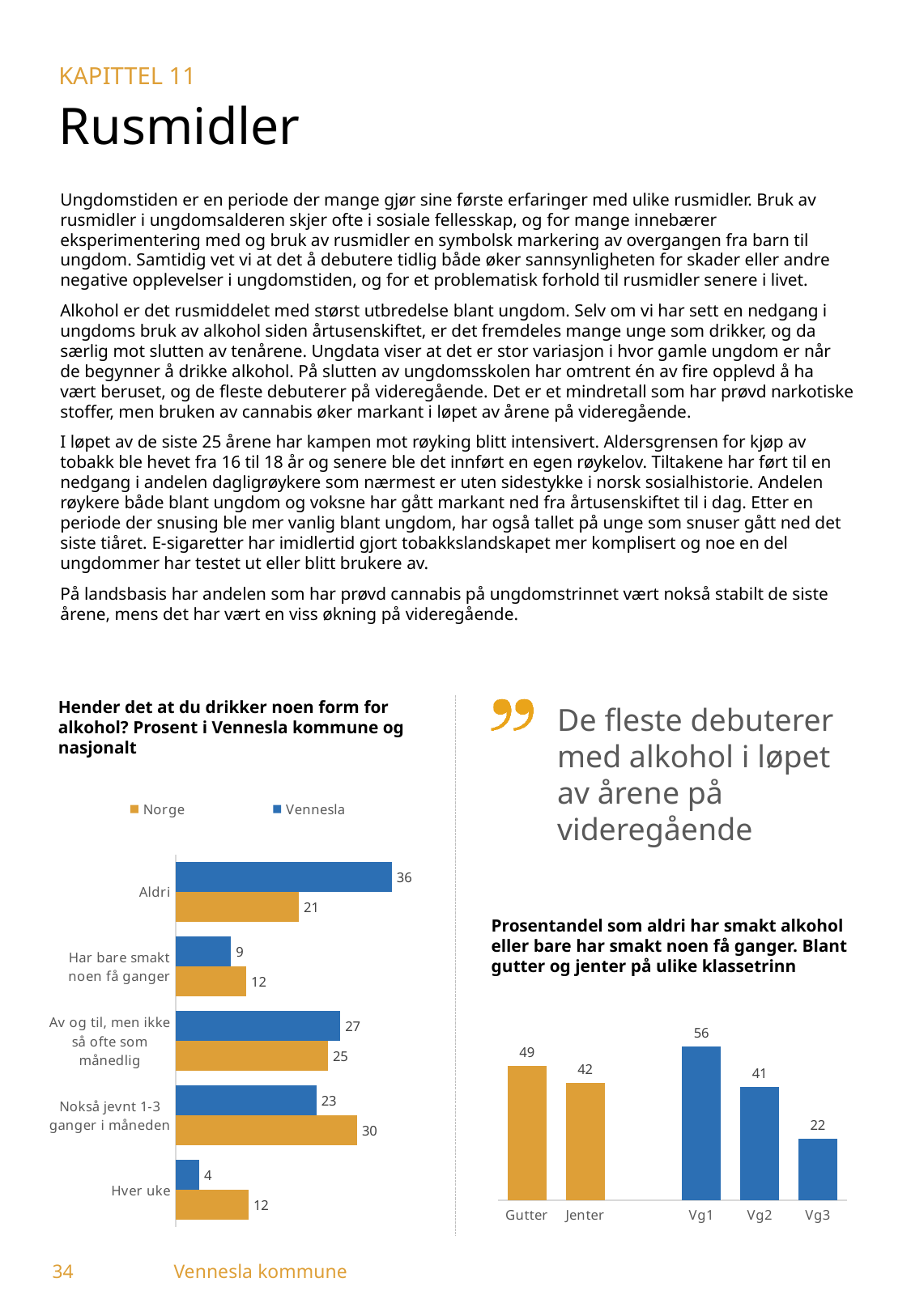
In the chart 'Prosentandel som aldri har smakt alkohol eller bare har smakt noen få ganger', which category has the lowest value? Vg3 In the chart 'Prosentandel som aldri har smakt alkohol eller bare har smakt noen få ganger', what is the value for Vg1? 56 In the chart 'Hender det at du drikker noen form for alkohol?', how many series does the legend list? 2 In the chart 'Hender det at du drikker noen form for alkohol?', what is the difference between Vennesla and Norge in the 'Aldri' category? 15 In the chart 'Prosentandel som aldri har smakt alkohol eller bare har smakt noen få ganger', what is the difference between Gutter and Jenter? 7 In the chart 'Hender det at du drikker noen form for alkohol?', what is the value for Vennesla in the 'Aldri' category? 36 What kind of chart is 'Hender det at du drikker noen form for alkohol?'? Bar chart In the chart 'Hender det at du drikker noen form for alkohol?', which is larger in the 'Nokså jevnt 1-3 ganger i måneden' category, Norge or Vennesla? Norge In the chart 'Hender det at du drikker noen form for alkohol?', what is the value for Norge in the 'Hver uke' category? 12 In the chart 'Hender det at du drikker noen form for alkohol?', how many categories are shown? 5 In the chart 'Prosentandel som aldri har smakt alkohol eller bare har smakt noen få ganger', do the values rise or fall from Vg1 to Vg3? Fall In the chart 'Hender det at du drikker noen form for alkohol?', which category has the lowest value for Vennesla? Hver uke